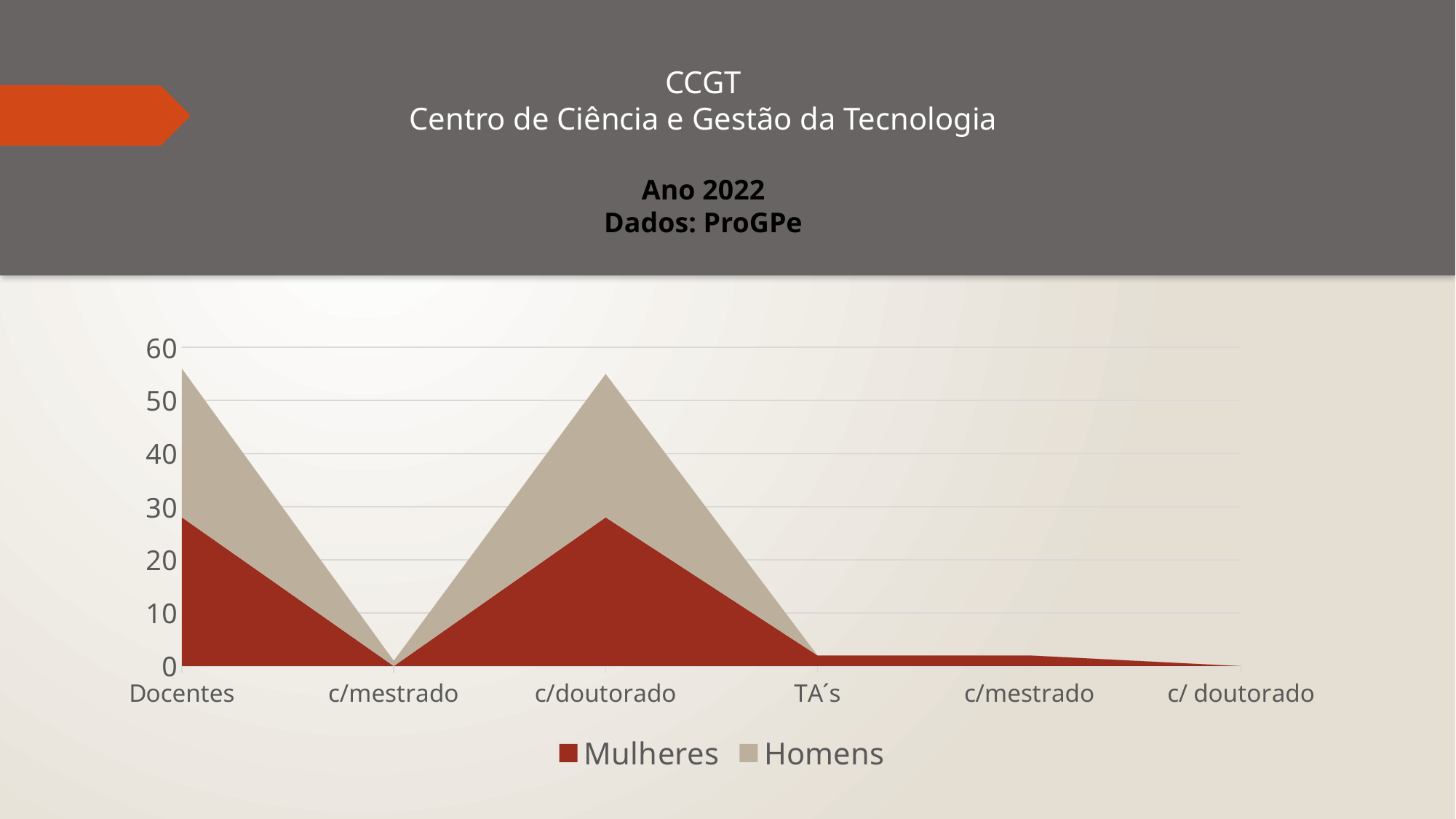
What are the two series named in the chart legend? Mulheres and Homens Is the value for Mulheres at TA´s greater or less than 10? less For the Mulheres series, which is larger: the value at Docentes or the value at the first c/mestrado category? Docentes How many categories are shown along the x axis of the chart? 6 Is the value for Homens at the first c/mestrado category greater or less than 10? less Is the value for Mulheres at Docentes greater or less than 20? greater How many series does the chart legend list? 2 Does the Mulheres series rise or fall from c/doutorado to TA´s? fall Which colour represents the Mulheres series in the chart? red What kind of chart is shown on the slide? area chart